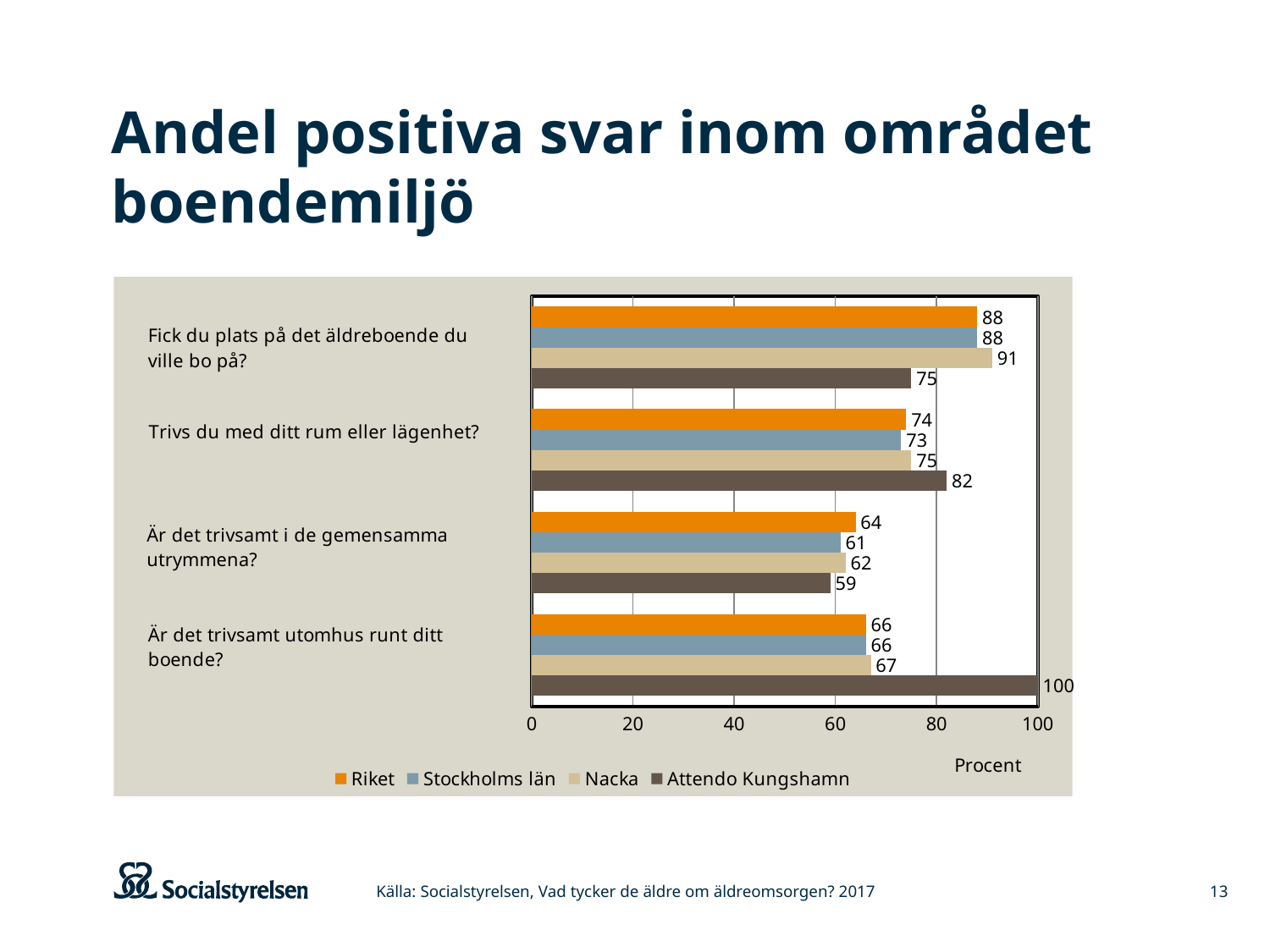
What is the value for Nacka for "Fick du plats på det äldreboende du ville bo på?"? 91 How many series does the legend list? 4 What is the label of the x axis? Procent What kind of chart is shown on the slide? Bar chart Which is larger for "Trivs du med ditt rum eller lägenhet?": Riket or Attendo Kungshamn? Attendo Kungshamn Which series has the lowest value for "Fick du plats på det äldreboende du ville bo på?"? Attendo Kungshamn How many questions (categories) are shown on the chart? 4 What is the difference between the Nacka and Attendo Kungshamn values for "Fick du plats på det äldreboende du ville bo på?"? 16 What is the value for Attendo Kungshamn for "Trivs du med ditt rum eller lägenhet?"? 82 What is the value for Stockholms län for "Är det trivsamt i de gemensamma utrymmena?"? 61 What is the value for Attendo Kungshamn for "Är det trivsamt utomhus runt ditt boende?"? 100 Which series has the highest value for "Är det trivsamt utomhus runt ditt boende?"? Attendo Kungshamn